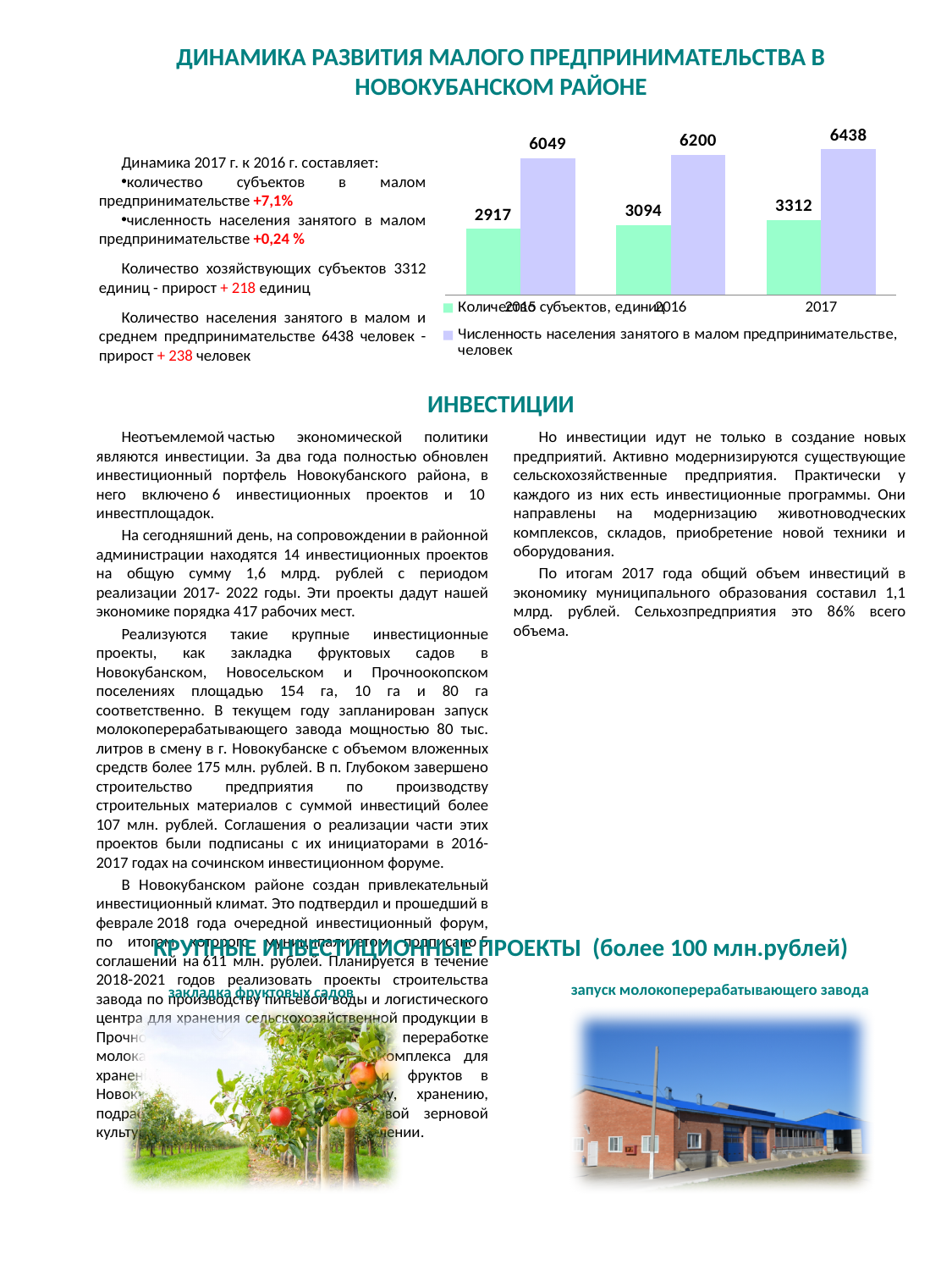
What is the value of 'Количество субъектов, единиц' for 2015? 2917 Do the values of 'Количество субъектов, единиц' rise or fall from 2015 to 2017? rise How many years are shown on the x axis of the chart? 3 In which year is 'Количество субъектов, единиц' the lowest? 2015 Which is larger: 'Численность населения занятого в малом предпринимательстве, человек' in 2015 or in 2016? 2016 What is the value of 'Численность населения занятого в малом предпринимательстве, человек' for 2017? 6438 In which year is 'Численность населения занятого в малом предпринимательстве, человек' the highest? 2017 What is the difference between 'Количество субъектов, единиц' in 2017 and in 2016? 218 How many series does the chart legend list? 2 What is the value of 'Численность населения занятого в малом предпринимательстве, человек' for 2016? 6200 What is the value of 'Количество субъектов, единиц' for 2017? 3312 What type of chart is shown on the slide? bar chart